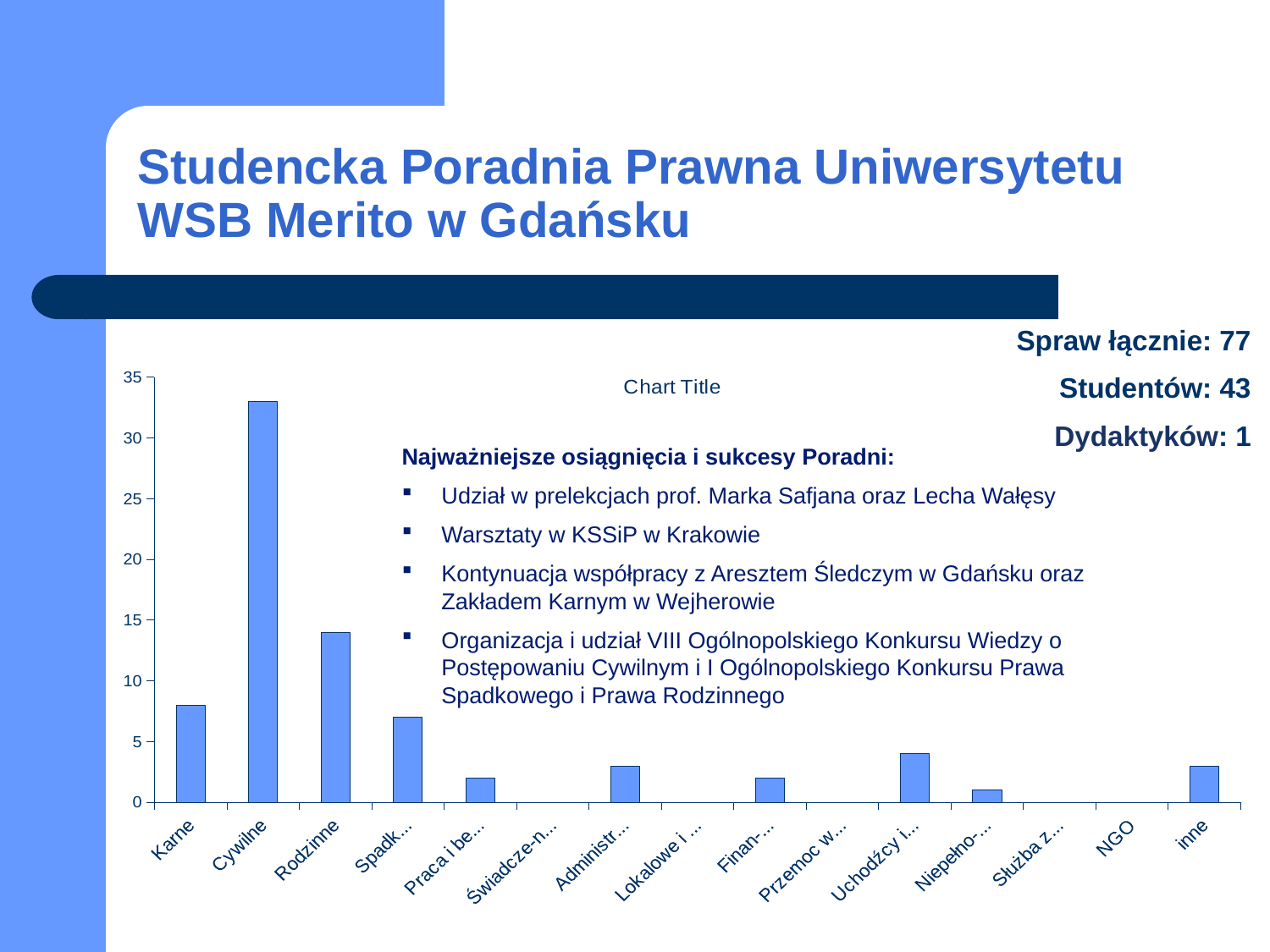
Is the value for Rodzinne greater or less than 15? less Which is larger, the value for Rodzinne or the value for Karne? Rodzinne Is the value for Karne greater or less than 5? greater Is the value for Uchodźcy i... greater or less than 5? less What kind of chart is shown on the slide? bar chart Which category has the highest bar in the chart? Cywilne What is the title shown on the chart? Chart Title How many categories are shown along the x axis of the chart? 15 Which is larger, the value for Cywilne or the value for Rodzinne? Cywilne